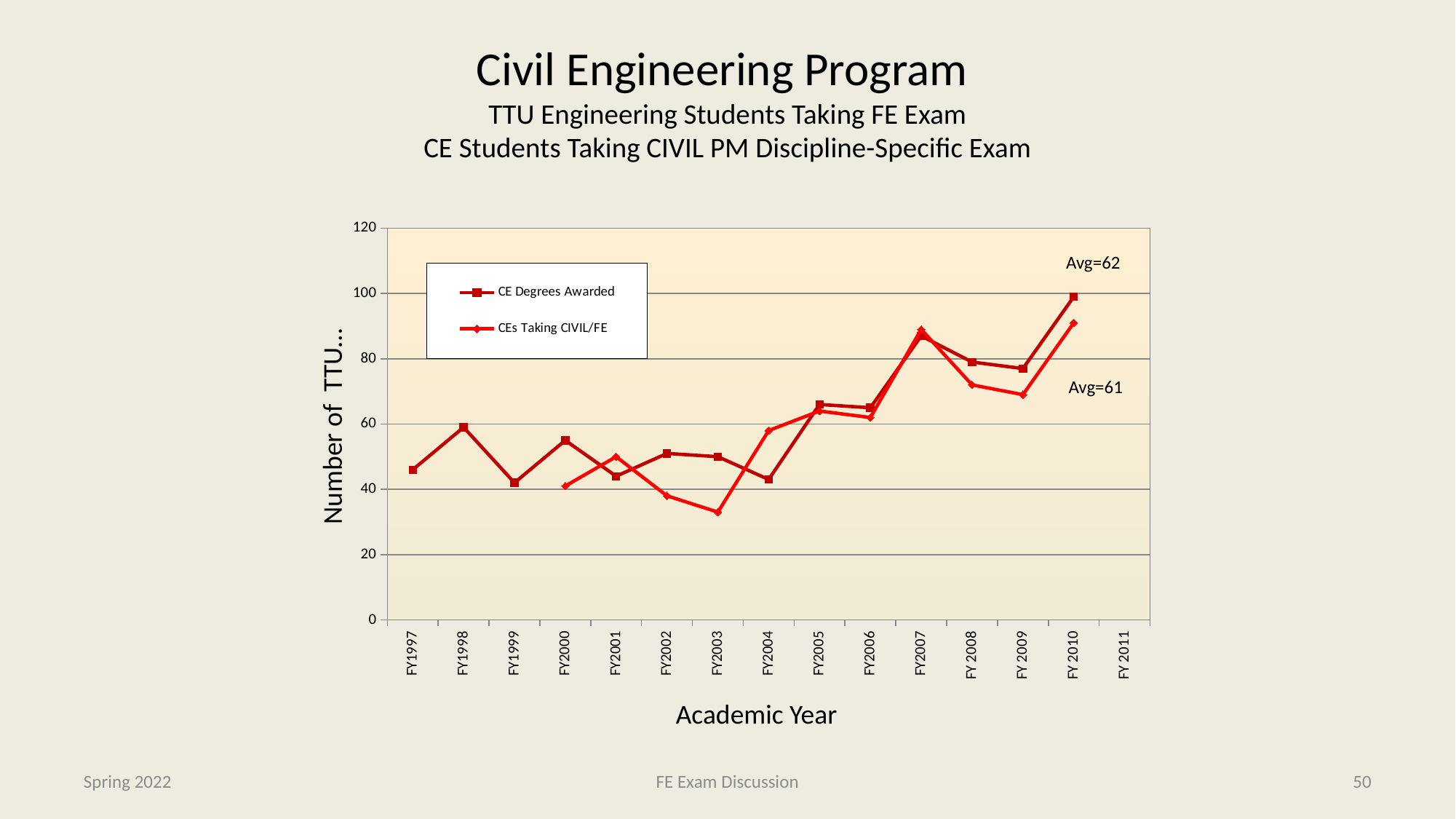
Is the value for CEs Taking CIVIL/FE in FY2003 greater or less than 40? less What are the two series named in the chart legend? CE Degrees Awarded and CEs Taking CIVIL/FE How many academic years are labeled on the x axis? 15 In which academic year is the CEs Taking CIVIL/FE series at its lowest? FY2003 What kind of chart is shown on the slide? line chart How many series does the chart legend list? 2 In which academic year is the CE Degrees Awarded series at its highest? FY 2010 What is the title of the x axis of the chart? Academic Year Does the CE Degrees Awarded series rise or fall from FY2004 to FY2007? rise Is the value for CE Degrees Awarded in FY 2010 greater or less than 80? greater In FY2003, which series has the larger value, CE Degrees Awarded or CEs Taking CIVIL/FE? CE Degrees Awarded In FY2004, which series has the larger value, CE Degrees Awarded or CEs Taking CIVIL/FE? CEs Taking CIVIL/FE